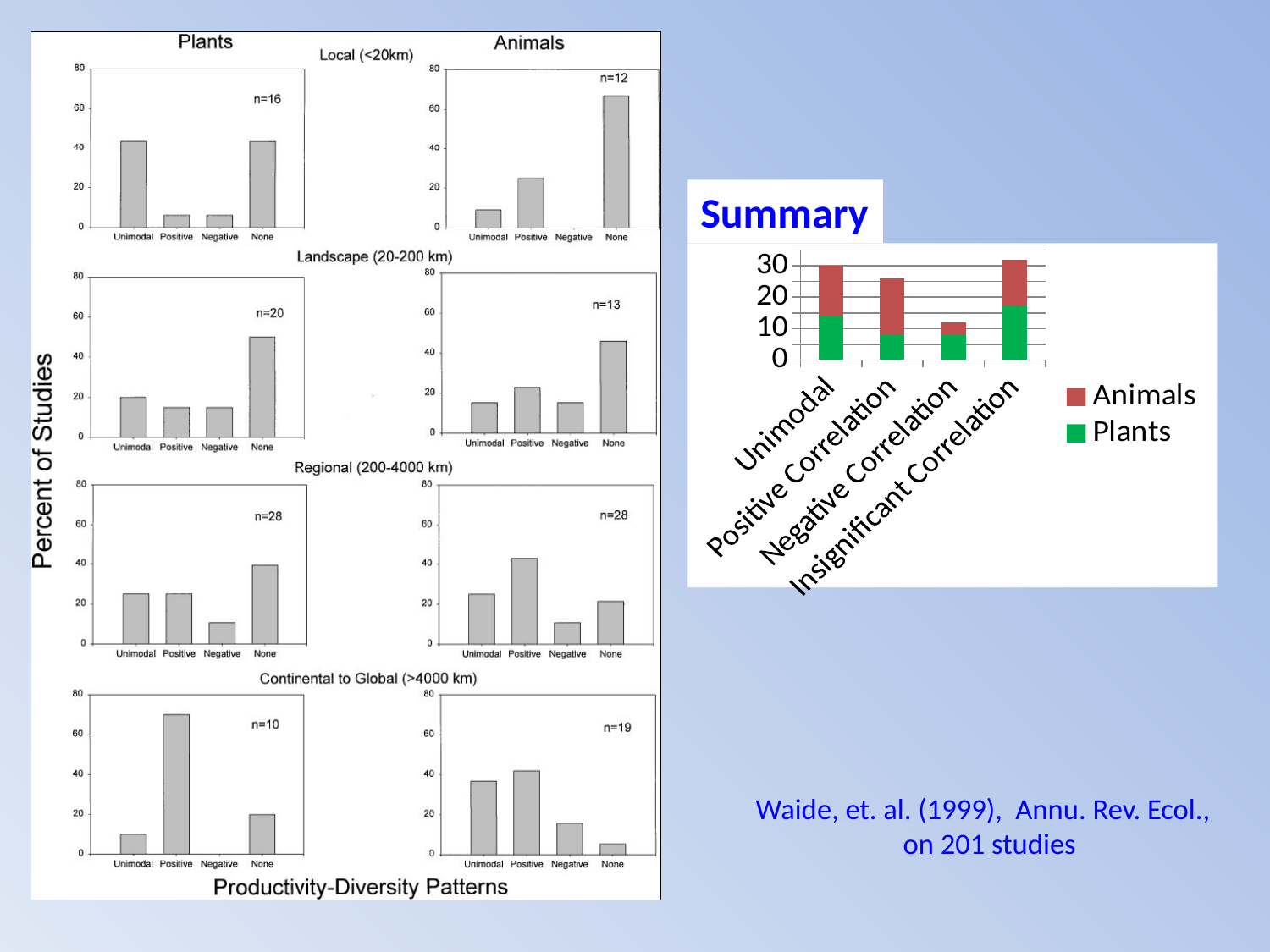
In the Summary chart, which category has the lowest total bar height? Negative Correlation In the Summary chart, which is larger: the total for Unimodal or the total for Negative Correlation? Unimodal In the Summary chart, which series is shown in green? Plants In the Local (<20km) Animals chart on the left figure, is the value for None greater or less than 60? greater In the Continental to Global (>4000 km) Plants chart on the left figure, which pattern has the highest percent of studies? Positive How many series does the legend of the Summary chart list? 2 How many categories are shown on the x axis of the Summary chart? 4 In the Summary chart, is the total for Negative Correlation greater or less than 20? less In the Summary chart, which category has the smallest Animals segment? Negative Correlation In the Summary chart, is the total for Unimodal greater or less than 20? greater What kind of chart is the Summary chart on the right of the slide? stacked bar chart